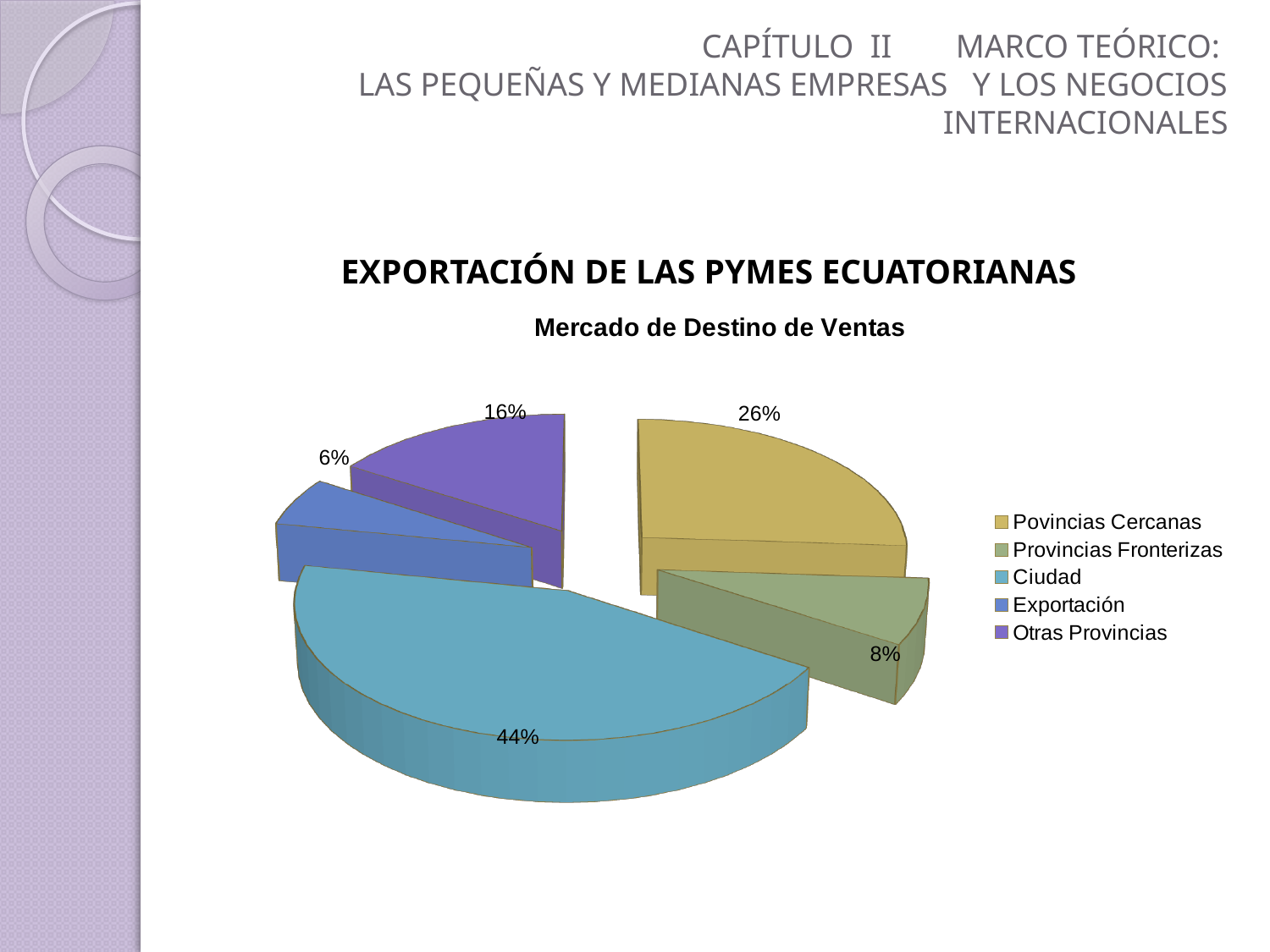
What is the difference in percentage points between Ciudad and Povincias Cercanas? 18 What share of the pie does Exportación represent? 6% What is the title of the chart? Mercado de Destino de Ventas Which is larger, the share for Otras Provincias or the share for Provincias Fronterizas? Otras Provincias Which category has the largest share of the pie? Ciudad What share of the pie does Ciudad represent? 44% What kind of chart is shown on the slide? Pie chart How many slices does the pie chart have? 5 Which category has the smallest share of the pie? Exportación What share of the pie does Povincias Cercanas represent? 26% What share of the pie does Provincias Fronterizas represent? 8% What share of the pie does Otras Provincias represent? 16%